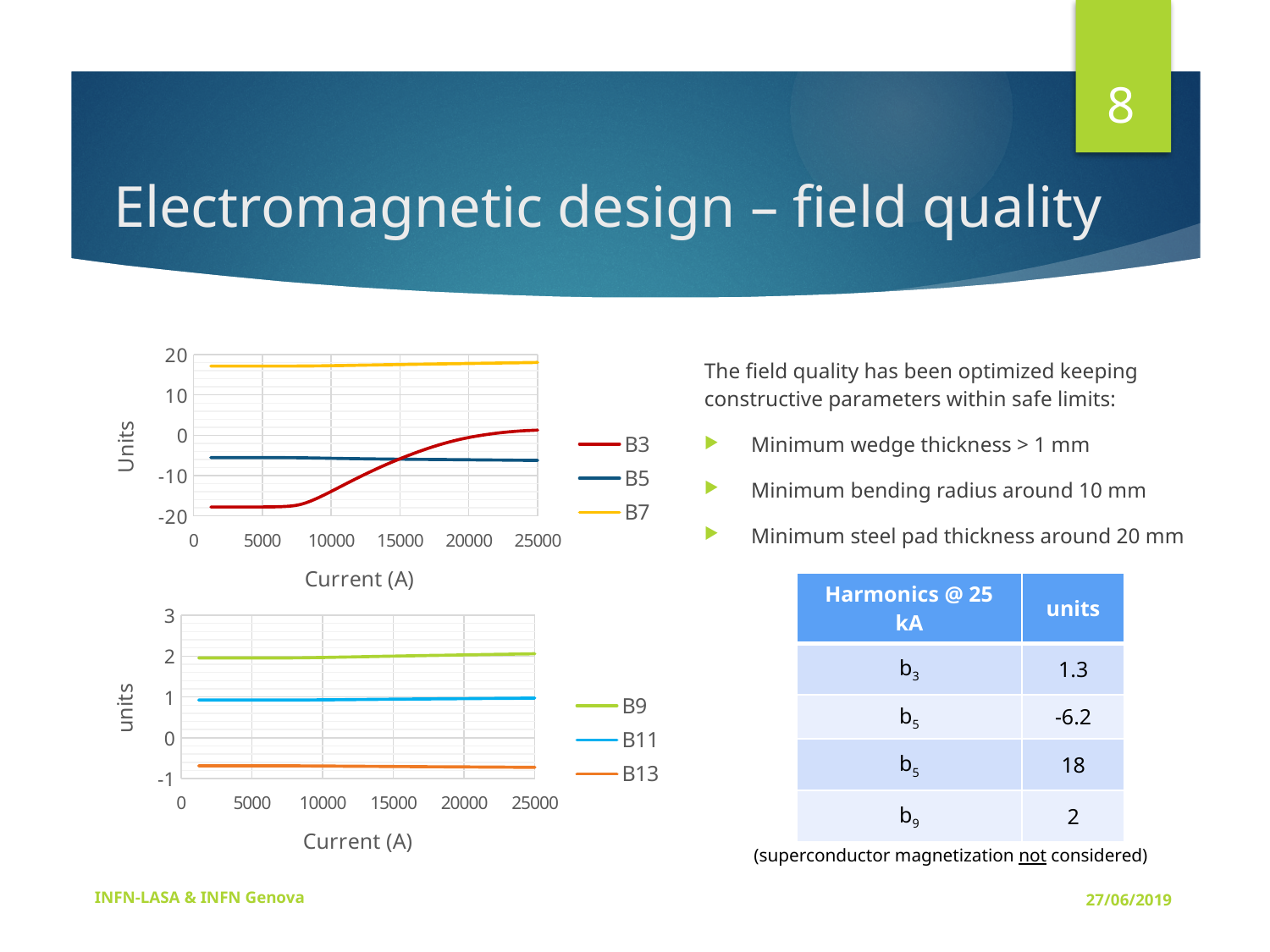
In the top chart, is the value of B7 at 25000 A greater or less than 10? greater What kind of chart is the top chart on the slide? line chart In the top chart, does the B3 series rise or fall as the current increases? rise In the bottom chart, which series has the lowest values across the current range? B13 How many series does the legend of the top chart list? 3 In the top chart, is the value of B3 at 5000 A greater or less than -10? less How many series does the legend of the bottom chart list? 3 In the top chart, is the value of B5 at 25000 A greater or less than 0? less In the top chart, which series has the highest values across the current range? B7 What is the x-axis label of the bottom chart? Current (A)